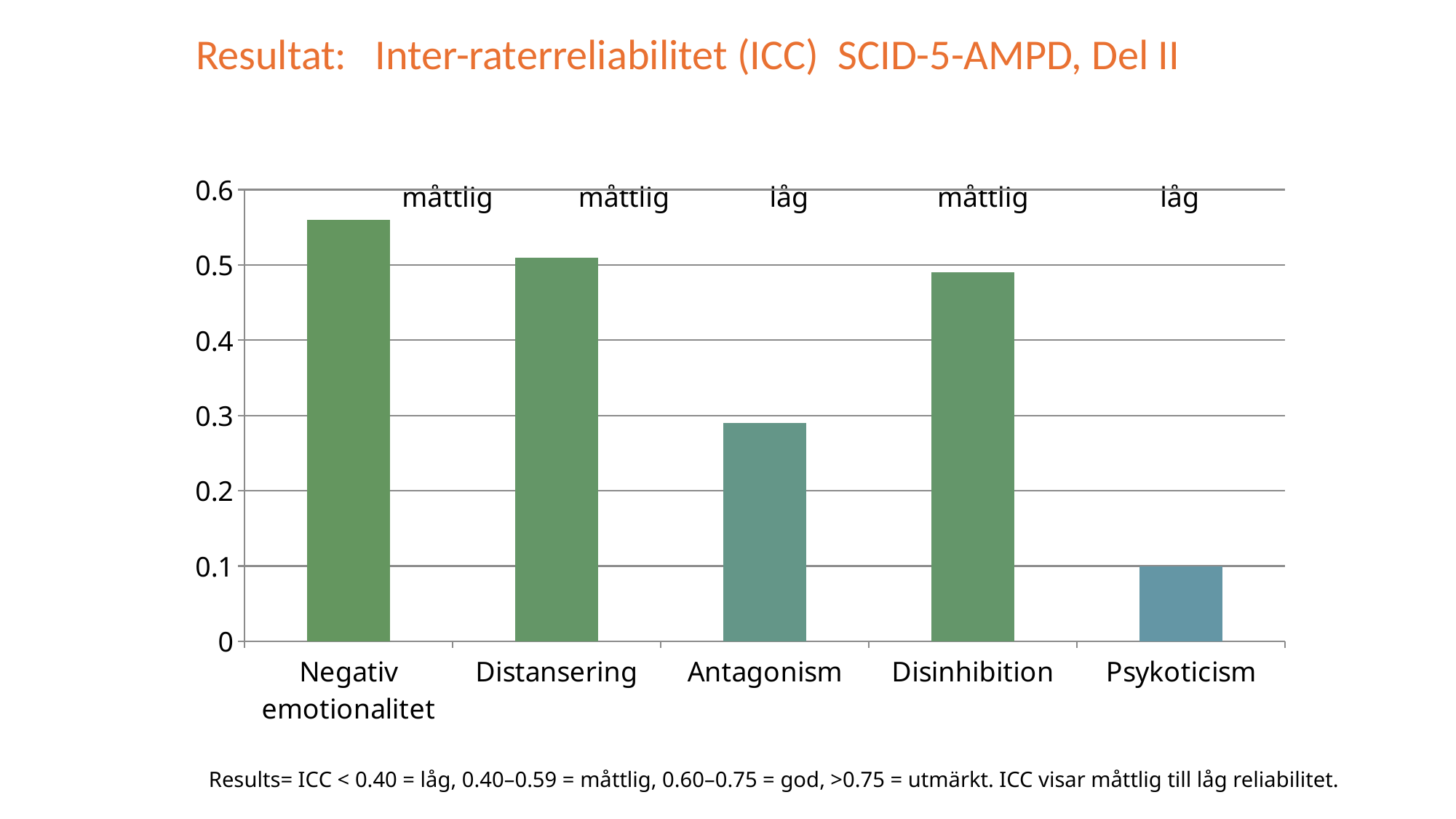
Is the value for Negativ emotionalitet greater or less than 0.5? greater What is the title of the slide containing the chart? Resultat: Inter-raterreliabilitet (ICC) SCID-5-AMPD, Del II What kind of chart is shown on the slide? bar chart What is the ICC value for Psykoticism? 0.1 Is the value for Distansering greater or less than 0.4? greater Which category has the lowest ICC value in the chart? Psykoticism Is the value for Antagonism greater or less than 0.4? less What reliability label is written above the Antagonism bar? låg Which category has the highest ICC value in the chart? Negativ emotionalitet Which is larger, the value for Distansering or the value for Antagonism? Distansering How many categories are shown on the x axis of the chart? 5